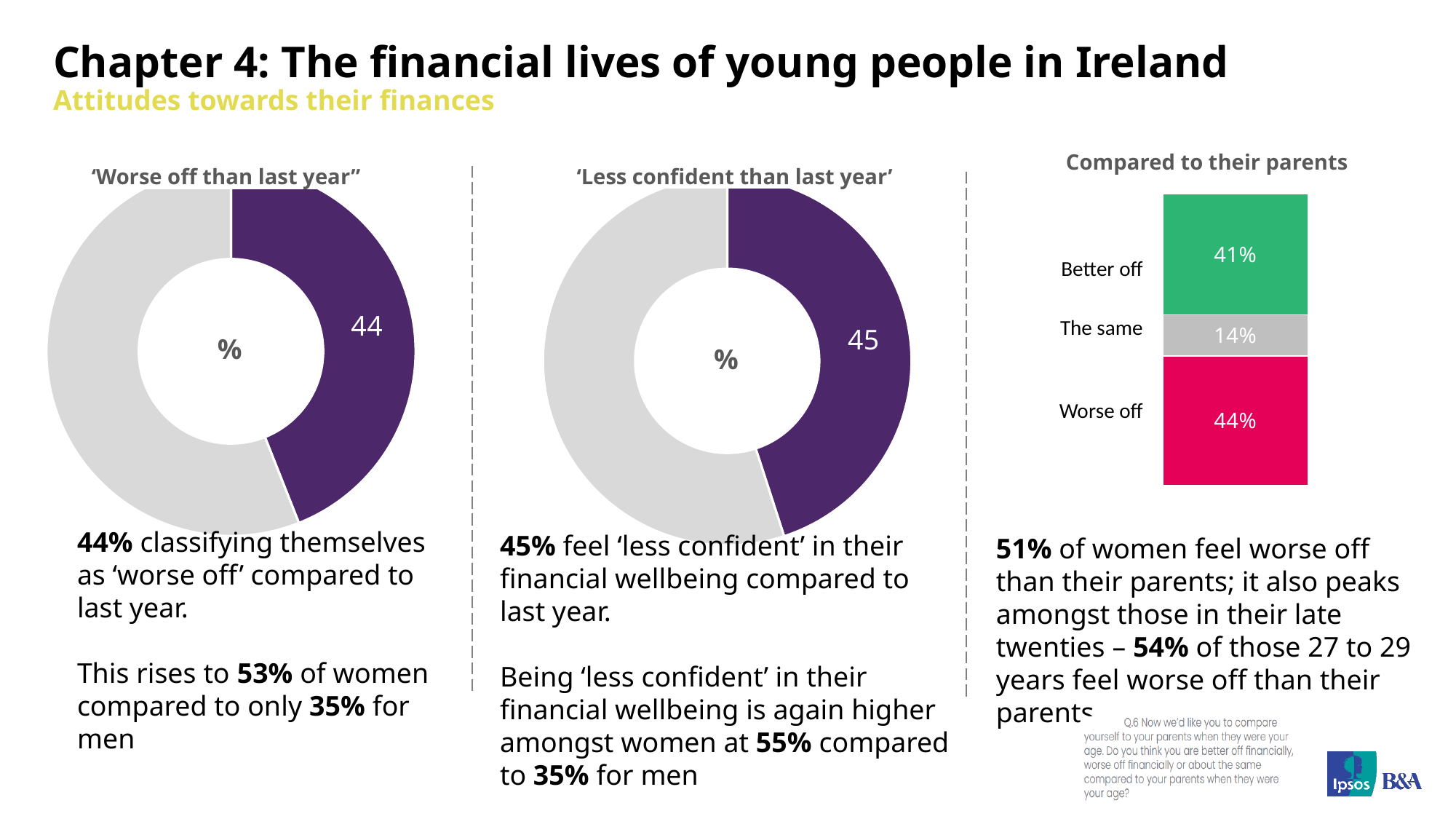
What kind of chart is the 'Worse off than last year' chart? Doughnut chart In the 'Less confident than last year' chart, what value is shown for the purple segment? 45 Which is larger: the purple segment in the 'Less confident than last year' chart or the purple segment in the 'Worse off than last year' chart? Less confident than last year In the 'Compared to their parents' chart, what percentage say they are the same? 14% In the 'Compared to their parents' chart, which category has the highest value? Worse off In the 'Compared to their parents' chart, what percentage say they are better off? 41% In the 'Compared to their parents' chart, how many categories are shown? 3 In the 'Compared to their parents' chart, which category has the lowest value? The same In the 'Compared to their parents' chart, what is the total of the three stacked segments? 99% In the 'Compared to their parents' chart, what is the difference between 'Worse off' and 'Better off'? 3% In the 'Worse off than last year' chart, what value is shown for the purple segment? 44 In the 'Compared to their parents' chart, what percentage say they are worse off? 44%